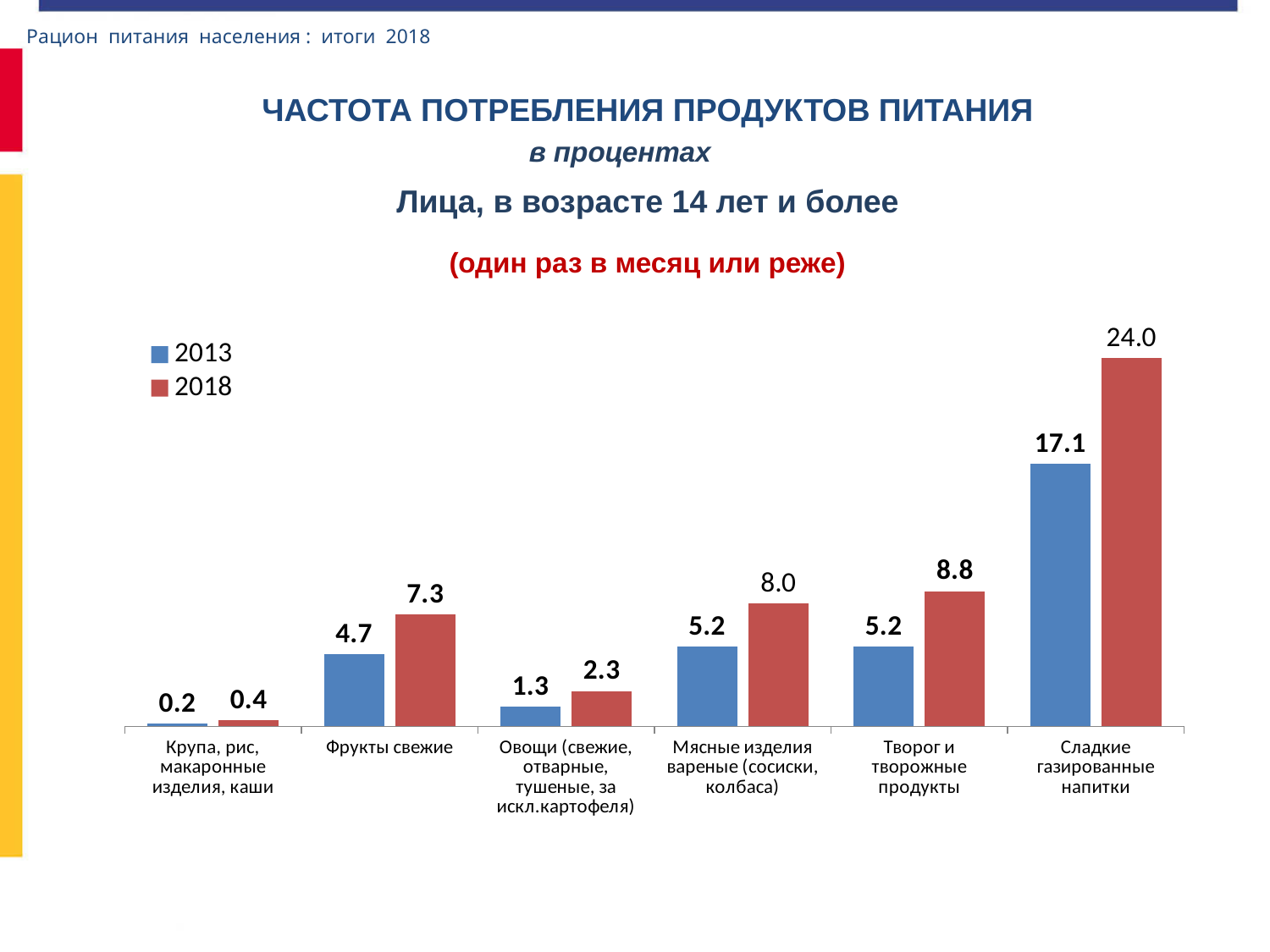
What is the 2018 value for Сладкие газированные напитки? 24.0 What is the difference between the 2018 and 2013 values for Творог и творожные продукты? 3.6 Which is larger: the 2018 value for Фрукты свежие or the 2018 value for Творог и творожные продукты? Творог и творожные продукты What is the 2018 value for Мясные изделия вареные (сосиски, колбаса)? 8.0 How many categories are shown on the x axis? 6 What is the 2013 value for Фрукты свежие? 4.7 Which category has the highest 2013 value? Сладкие газированные напитки What is the difference between the 2018 and 2013 values for Сладкие газированные напитки? 6.9 Which category has the lowest 2018 value? Крупа, рис, макаронные изделия, каши Which colour represents the 2018 series? Red How many series does the legend list? 2 What kind of chart is shown on the slide? Bar chart